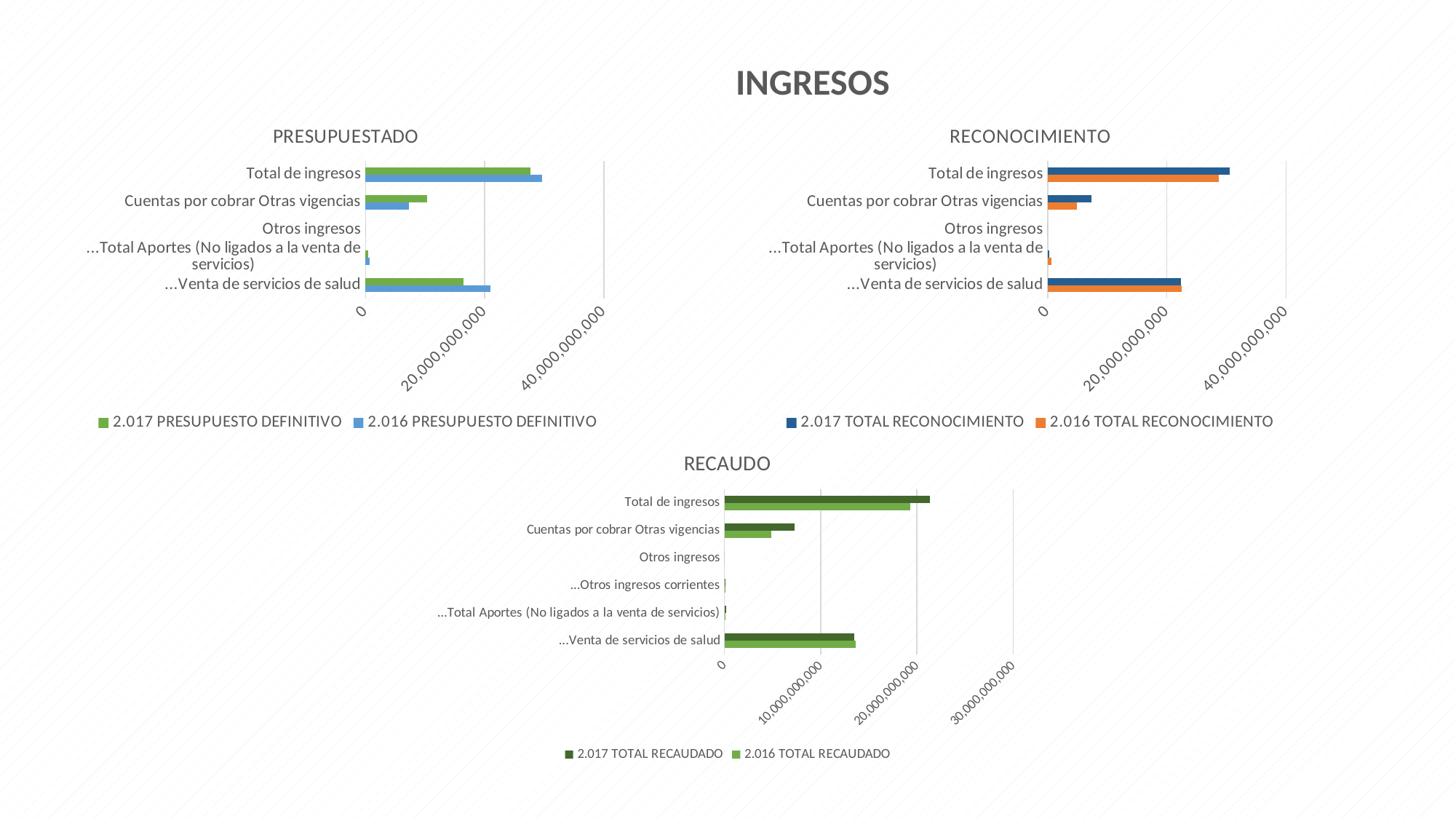
What kind of chart is the PRESUPUESTADO chart? bar chart In the PRESUPUESTADO chart, is the value of 2.016 PRESUPUESTO DEFINITIVO for Total de ingresos greater or less than 20,000,000,000? greater In the RECAUDO chart, is the value of 2.017 TOTAL RECAUDADO for Cuentas por cobrar Otras vigencias greater or less than 10,000,000,000? less How many categories are shown on the PRESUPUESTADO chart? 5 In the PRESUPUESTADO chart, which series has the larger value for ...Venta de servicios de salud, 2.017 PRESUPUESTO DEFINITIVO or 2.016 PRESUPUESTO DEFINITIVO? 2.016 PRESUPUESTO DEFINITIVO In the RECAUDO chart, which category has the highest value for 2.017 TOTAL RECAUDADO? Total de ingresos How many categories are shown on the RECAUDO chart? 6 In the RECONOCIMIENTO chart, which series has the larger value for Cuentas por cobrar Otras vigencias, 2.017 TOTAL RECONOCIMIENTO or 2.016 TOTAL RECONOCIMIENTO? 2.017 TOTAL RECONOCIMIENTO In the RECONOCIMIENTO chart, is the value of 2.017 TOTAL RECONOCIMIENTO for ...Venta de servicios de salud greater or less than 20,000,000,000? greater In the PRESUPUESTADO chart, which series has the larger value for Cuentas por cobrar Otras vigencias, 2.017 PRESUPUESTO DEFINITIVO or 2.016 PRESUPUESTO DEFINITIVO? 2.017 PRESUPUESTO DEFINITIVO How many series does the legend of the RECONOCIMIENTO chart list? 2